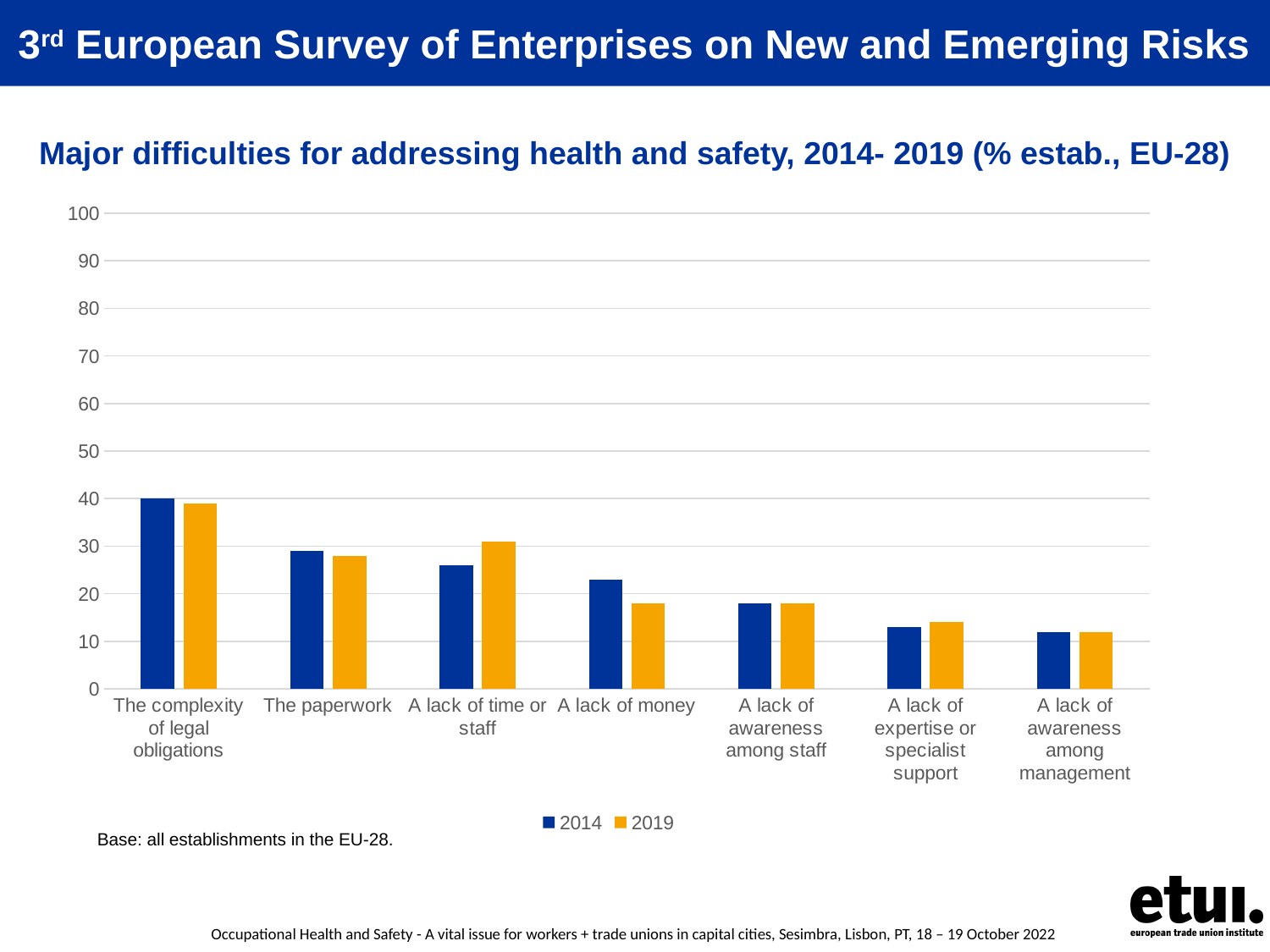
Is the 2014 value for 'A lack of expertise or specialist support' greater or less than 20? less How many series does the legend list? 2 Which difficulty has the lowest value for 2019? A lack of awareness among management For 'A lack of time or staff', which year has the larger value, 2014 or 2019? 2019 How many difficulty categories are shown along the x axis? 7 Which difficulty has the highest value for 2014? The complexity of legal obligations What is the title of the chart? Major difficulties for addressing health and safety, 2014- 2019 (% estab., EU-28) What kind of chart is shown on the slide? bar chart Which year is represented by the orange bars in the legend? 2019 For 'A lack of money', which year has the larger value, 2014 or 2019? 2014 Is the 2019 value for 'The complexity of legal obligations' greater or less than 30? greater